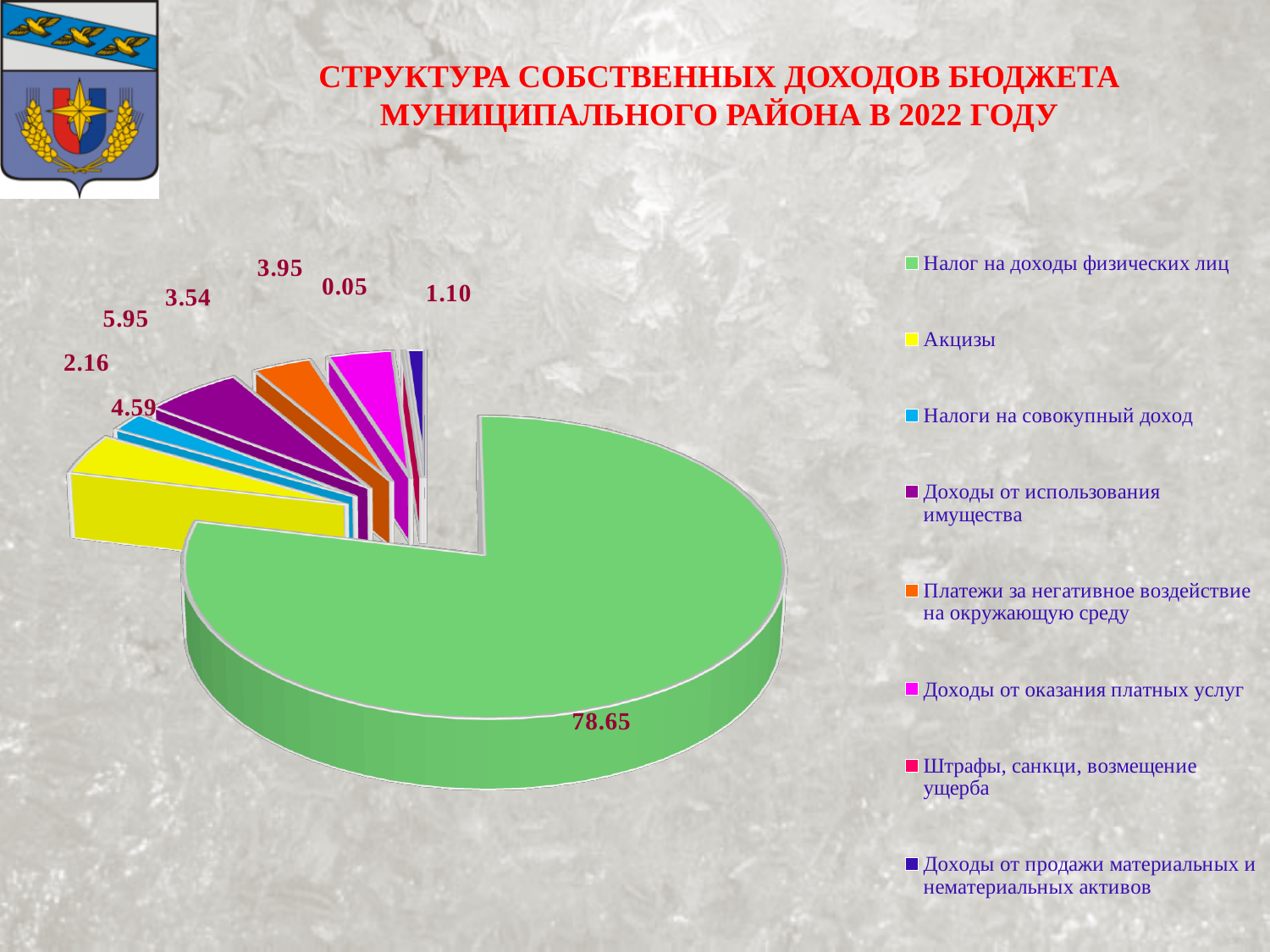
What is the value shown for Налог на доходы физических лиц? 78.65 What is the difference between the values for Доходы от использования имущества and Платежи за негативное воздействие на окружающую среду? 2.41 What is the value shown for Доходы от использования имущества? 5.95 What is the value shown for Акцизы? 4.59 What is the value shown for Доходы от продажи материальных и нематериальных активов? 1.10 Which category has the smallest share of the pie? Штрафы, санкци, возмещение ущерба What is the value shown for Штрафы, санкци, возмещение ущерба? 0.05 Which category has the largest share of the pie? Налог на доходы физических лиц What kind of chart is shown on the slide? pie chart How many categories does the legend of the pie chart list? 8 Which is larger, the value for Акцизы or the value for Налоги на совокупный доход? Акцизы What colour is the slice for Налог на доходы физических лиц? green